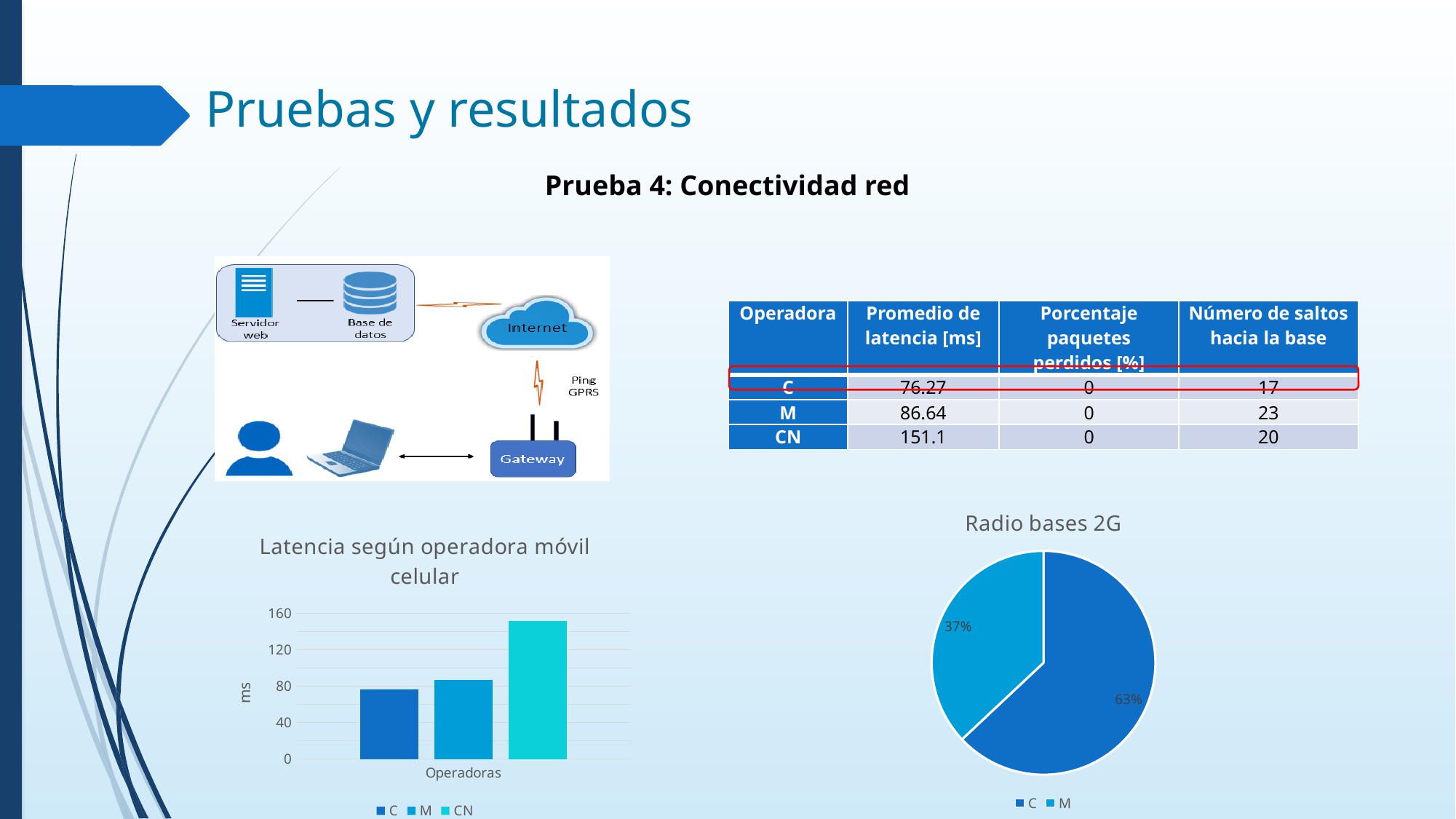
In the "Latencia según operadora móvil celular" chart, which operator has the lowest latency? C In the "Latencia según operadora móvil celular" chart, is the value for M greater or less than 80? greater In the "Latencia según operadora móvil celular" chart, how many series does the legend list? 3 In the "Radio bases 2G" pie chart, which slice is larger, C or M? C In the "Latencia según operadora móvil celular" chart, is the value for CN greater or less than 120? greater In the "Radio bases 2G" pie chart, what share does M have? 37% In the "Latencia según operadora móvil celular" chart, which operator has the highest latency? CN In the "Radio bases 2G" pie chart, what share does C have? 63% What kind of chart is "Latencia según operadora móvil celular"? bar chart In the "Latencia según operadora móvil celular" chart, what is the label on the vertical axis? ms In the "Latencia según operadora móvil celular" chart, is the value for C greater or less than 80? less What kind of chart is "Radio bases 2G"? pie chart